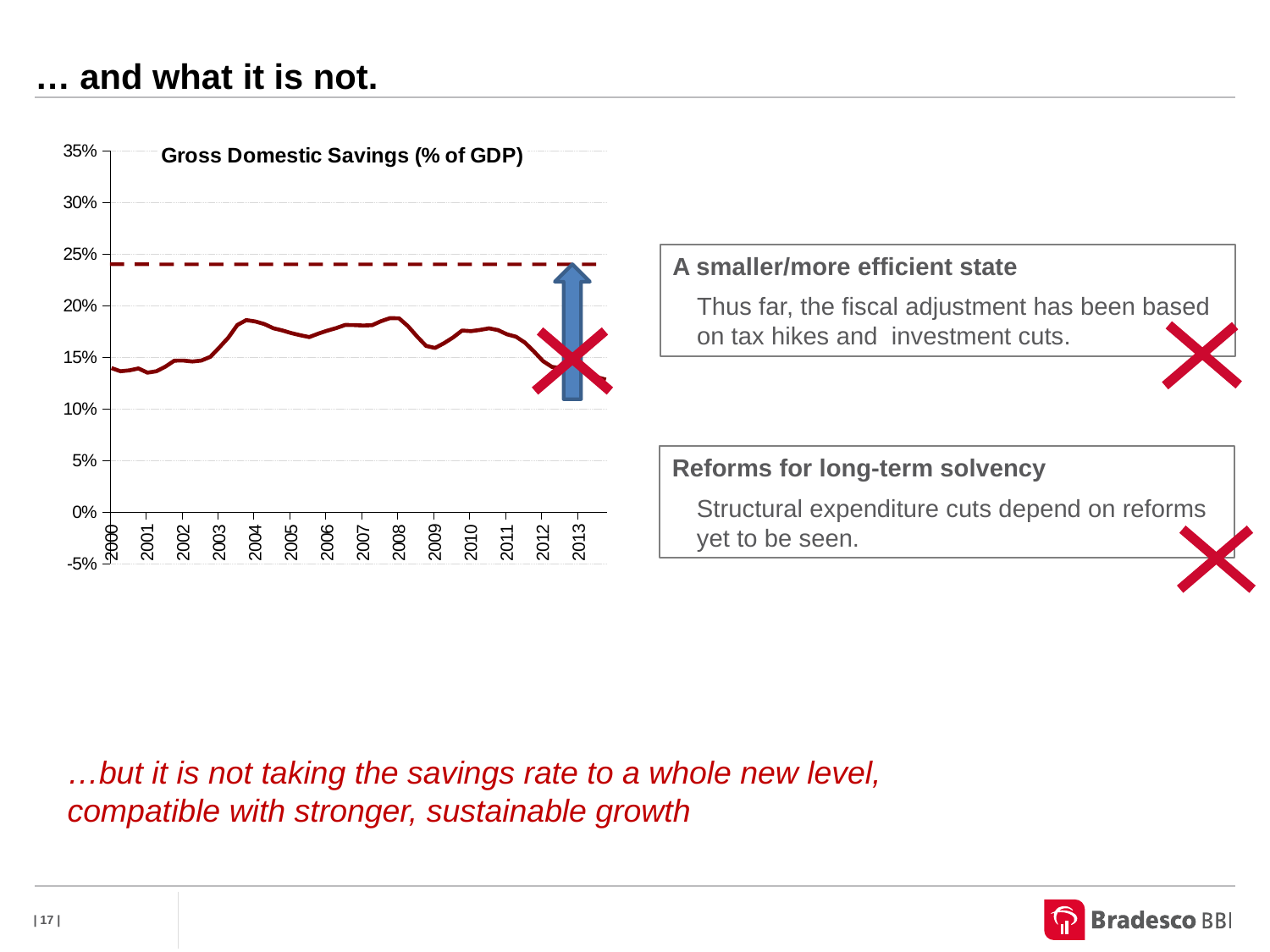
Does the line rise or fall from 2011 to 2013? fall Is the dashed horizontal line greater or less than 20%? greater Is the value for 2013 greater or less than 20%? less How many years are labeled on the x axis of the chart? 14 Which is larger, the value for 2004 or the value for 2001? 2004 Does the line rise or fall from 2001 to 2004? rise What kind of chart is shown on the slide? line chart Is the value for 2008 greater or less than 15%? greater Which is larger, the value for 2008 or the value for 2000? 2008 What is the title of the chart? Gross Domestic Savings (% of GDP)